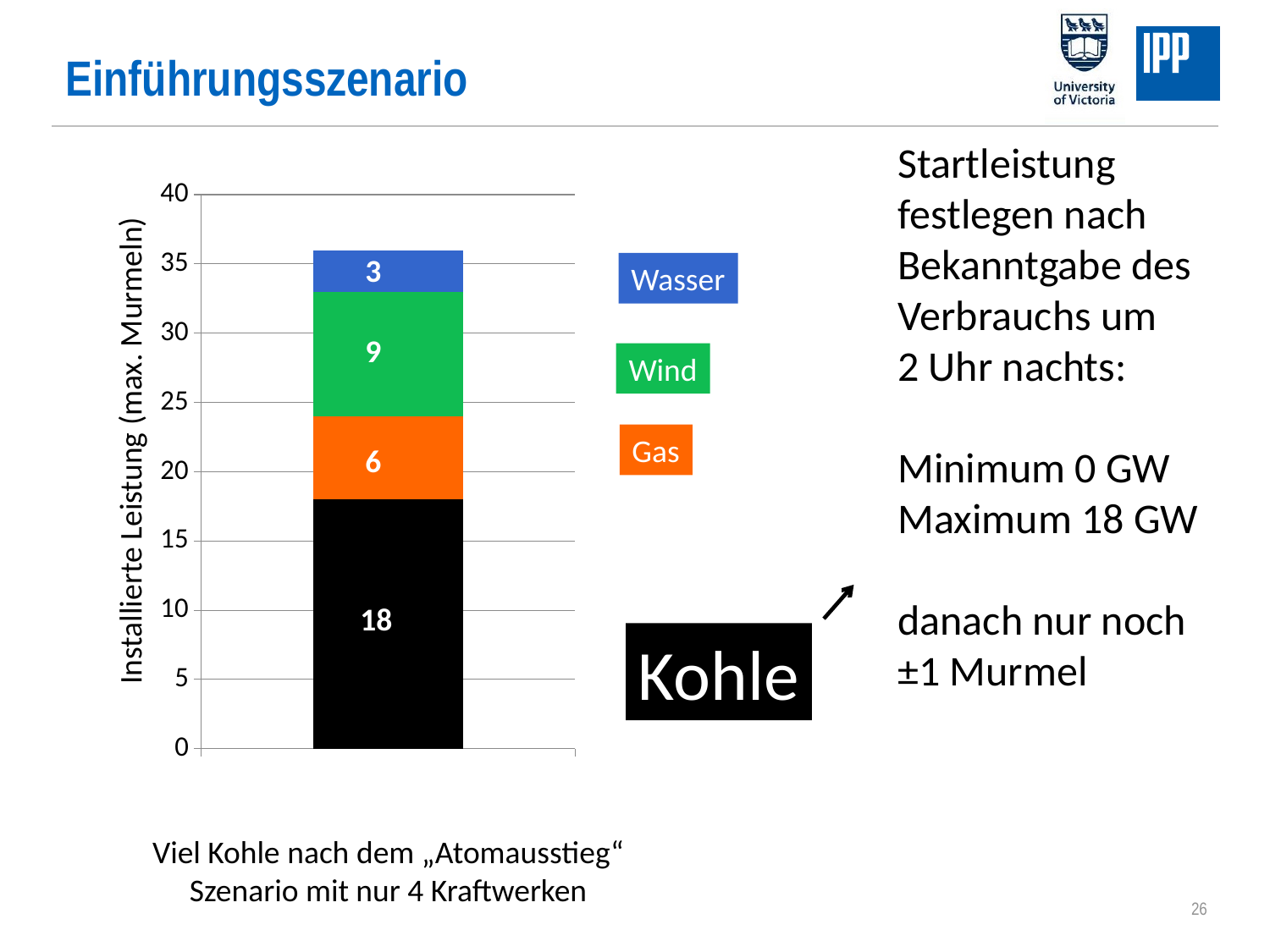
What is the difference between the Kohle and Wind segments? 9 How many segments (energy sources) make up the stacked bar? 4 What type of chart is shown on the slide? stacked bar chart Which energy source has the smallest segment in the stacked bar? Wasser Which energy source has the largest segment in the stacked bar? Kohle What is the value of the Gas segment in the stacked bar? 6 What is the value of the Wind segment in the stacked bar? 9 What is the label of the y-axis of the chart? Installierte Leistung (max. Murmeln) What is the total height of the stacked bar? 36 Which segment is larger, Gas or Wind? Wind What is the value of the Wasser segment in the stacked bar? 3 What is the value of the Kohle segment in the stacked bar? 18